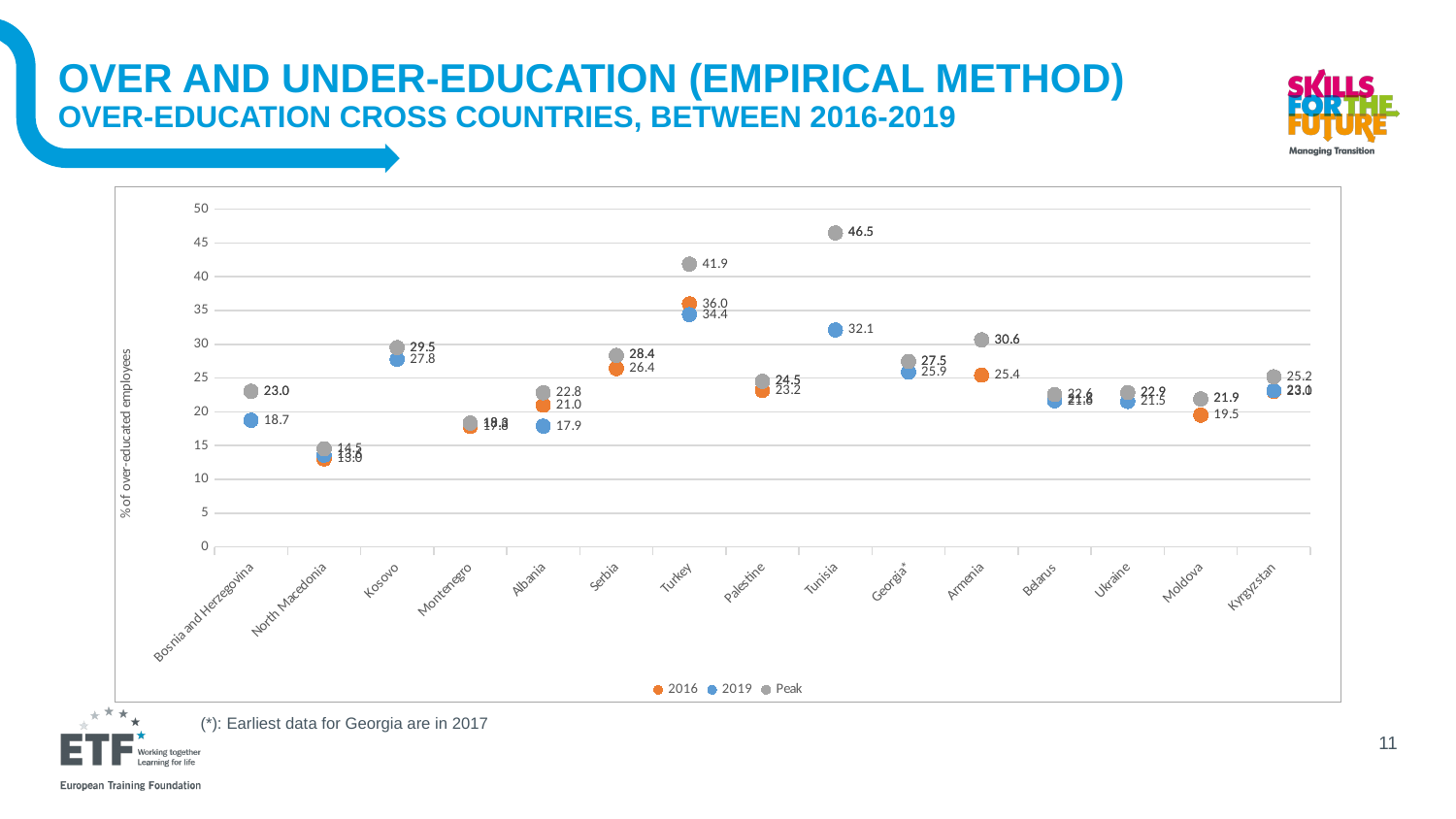
Which country has the lowest Peak value? North Macedonia Is the 2019 value for Tunisia greater or less than 30? greater Which is larger, the Peak value for Kosovo or the Peak value for Serbia? Kosovo How many countries are shown on the x axis? 15 What are the three entries in the legend? 2016, 2019, Peak How many series does the legend list? 3 What is the difference between the Peak value and the 2019 value for Turkey? 7.5 What kind of chart is shown on the slide? scatter chart Which country has the highest Peak value? Tunisia What is the 2019 value for Turkey? 34.4 What is the difference between the 2016 and 2019 values for Albania? 3.1 What is the Peak value for Tunisia? 46.5